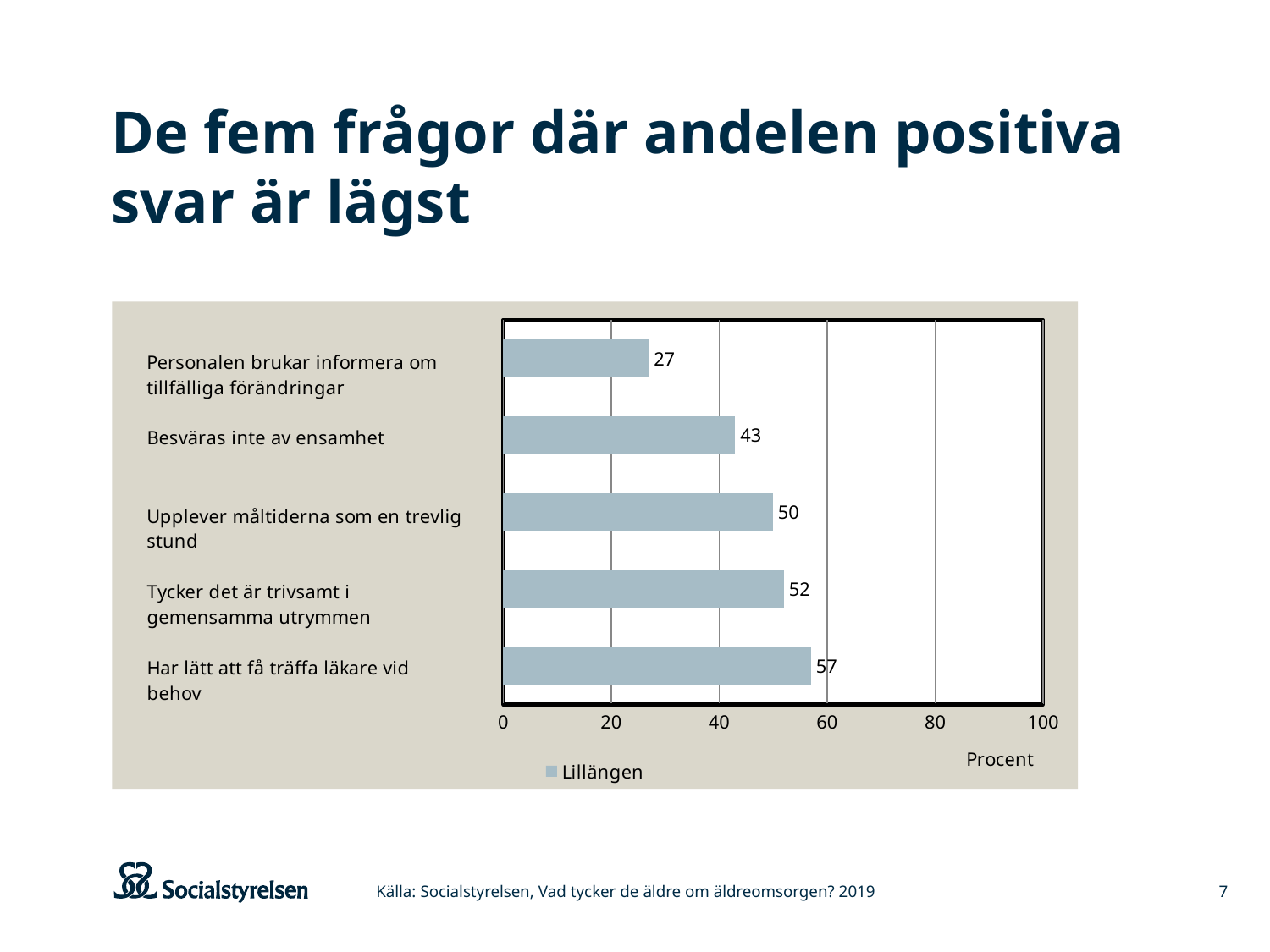
What is the value for "Har lätt att få träffa läkare vid behov"? 57 What is the name of the series shown in the legend? Lillängen Which is larger: the value for "Besväras inte av ensamhet" or the value for "Upplever måltiderna som en trevlig stund"? Upplever måltiderna som en trevlig stund Which category has the lowest value? Personalen brukar informera om tillfälliga förändringar How many series does the legend list? 1 What is the difference between the values for "Tycker det är trivsamt i gemensamma utrymmen" and "Upplever måltiderna som en trevlig stund"? 2 What is the value for "Personalen brukar informera om tillfälliga förändringar"? 27 Is the value for "Har lätt att få träffa läkare vid behov" greater or less than 60? less How many categories are shown in the chart? 5 What is the value for "Besväras inte av ensamhet"? 43 What kind of chart is shown on the slide? bar chart Which category has the highest value? Har lätt att få träffa läkare vid behov